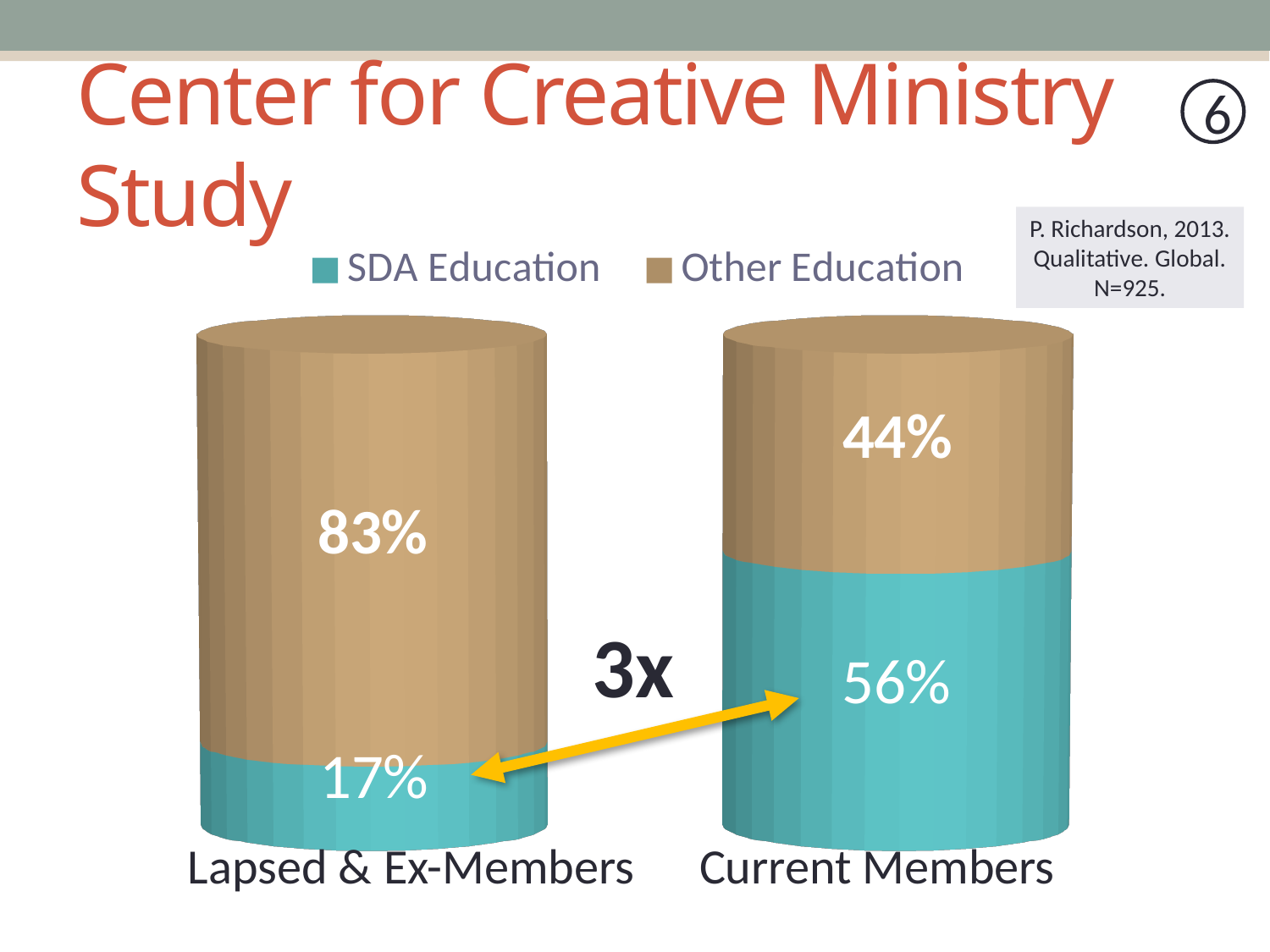
Which colour represents SDA Education in the chart? Teal How many categories are shown on the x axis? 2 Which category has the higher share of SDA Education? Current Members How many series does the legend list? 2 What kind of chart is shown on the slide? Stacked bar chart What is the difference in SDA Education share between Current Members and Lapsed & Ex-Members? 39 percentage points What percentage of Current Members had SDA Education? 56% Which category has the lower share of Other Education? Current Members What percentage of Lapsed & Ex-Members had Other Education? 83% What percentage of Lapsed & Ex-Members had SDA Education? 17% Is the Other Education share larger for Lapsed & Ex-Members or for Current Members? Lapsed & Ex-Members What percentage of Current Members had Other Education? 44%